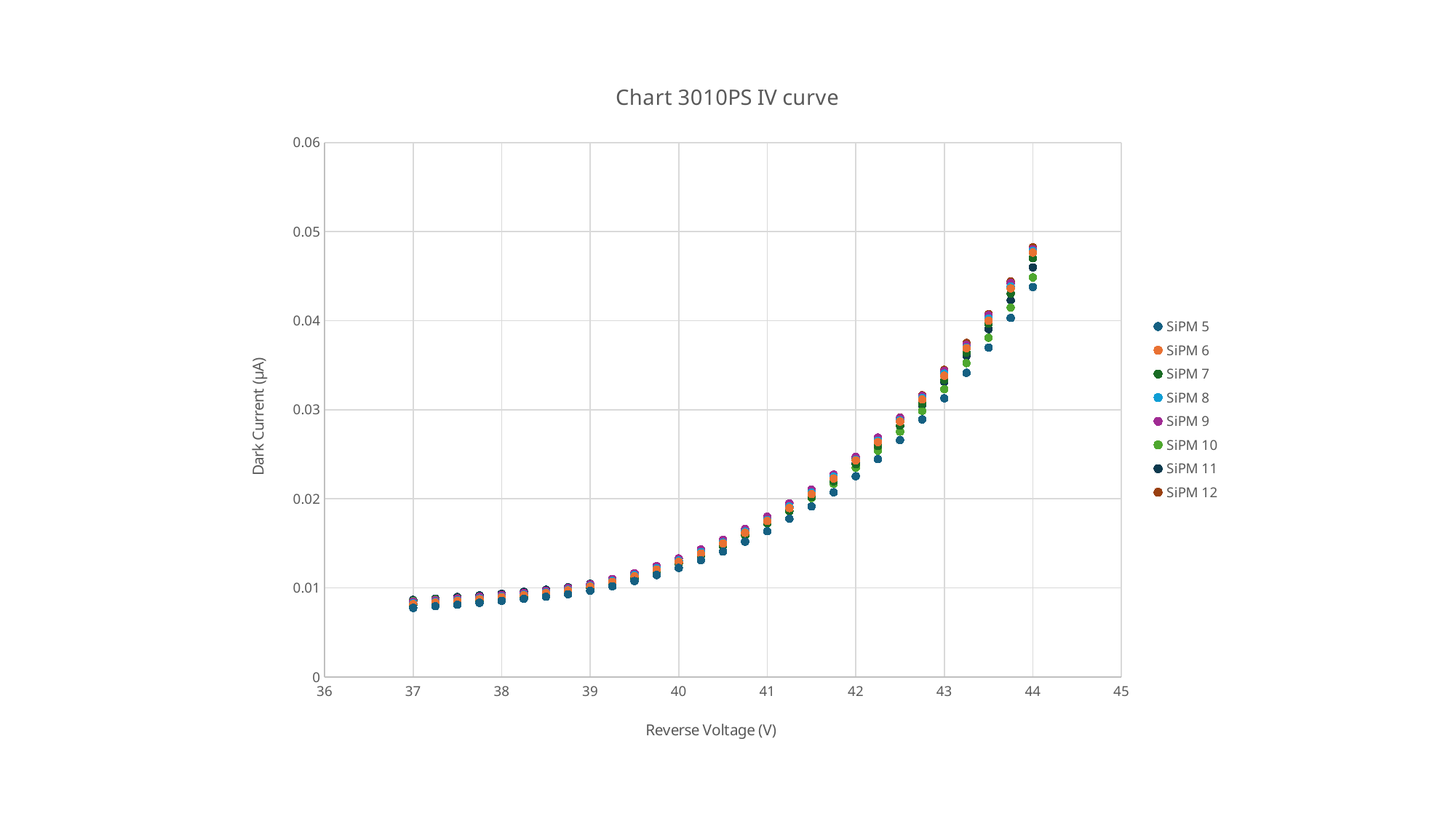
At 44 V, which series has the lowest dark current? SiPM 5 How many series does the legend list? 8 At 44 V, which is larger: the value for SiPM 5 or the value for SiPM 12? SiPM 12 What kind of chart is shown on the slide? scatter chart Is the value for SiPM 12 at 44 V greater or less than 0.04? greater Is the value for SiPM 9 at 42 V greater or less than 0.02? greater Is the value for SiPM 5 at 37 V greater or less than 0.01? less What is the label of the vertical axis? Dark Current (µA) Do the dark current values rise or fall as the reverse voltage increases from 37 V to 44 V? rise What is the title of the chart? Chart 3010PS IV curve